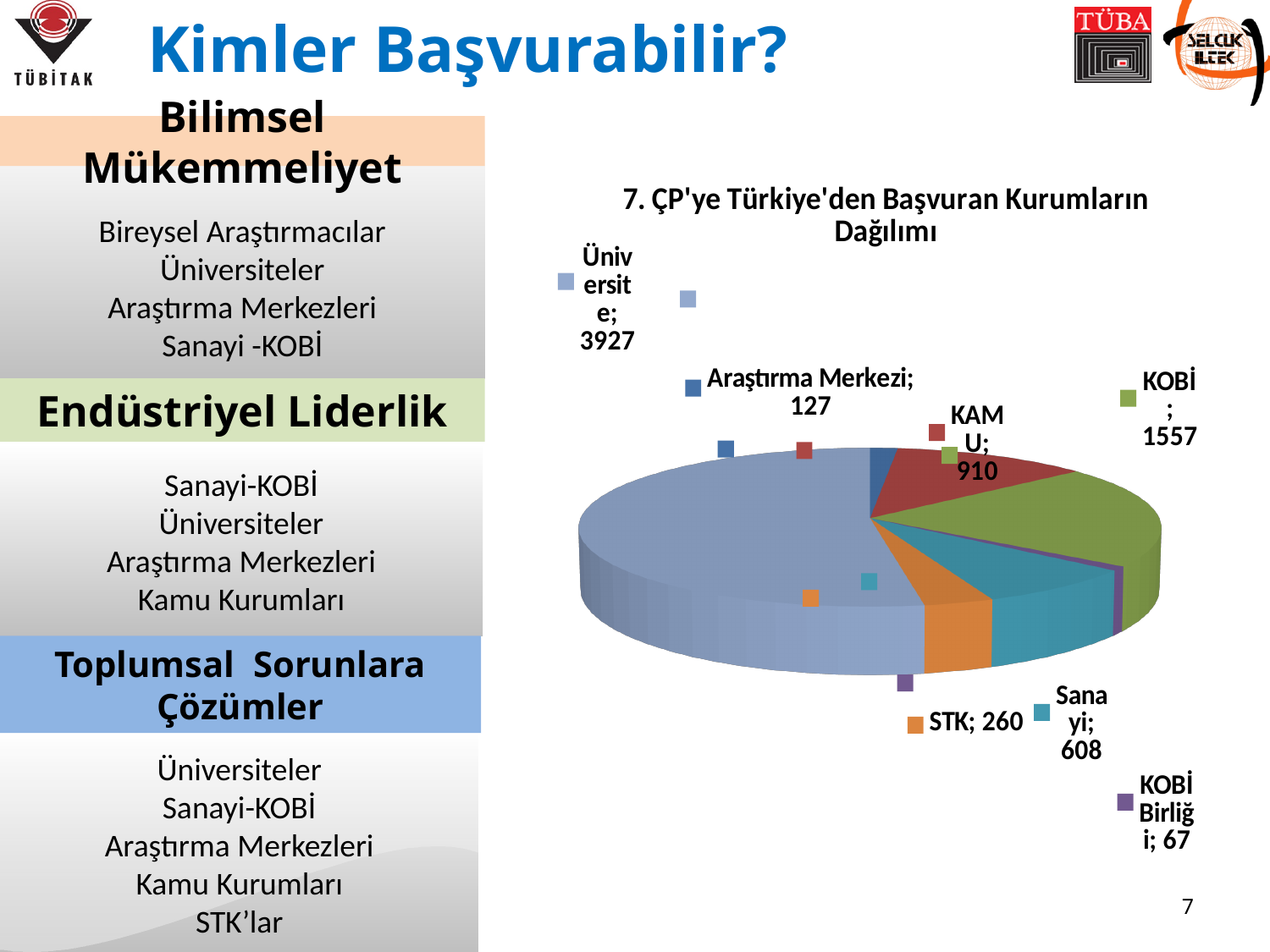
What kind of chart is shown on the slide? Pie chart What is the value for Üniversite? 3927 Which is larger, the value for KAMU or the value for Sanayi? KAMU What is the value for KOBİ? 1557 What is the title of the chart? 7. ÇP'ye Türkiye'den Başvuran Kurumların Dağılımı How many categories does the pie chart show? 7 What is the value for STK? 260 What is the value for Araştırma Merkezi? 127 What is the difference between the values for Üniversite and KOBİ? 2370 Which category has the highest value? Üniversite What is the difference between the values for KAMU and Sanayi? 302 Which category has the lowest value? KOBİ Birliği